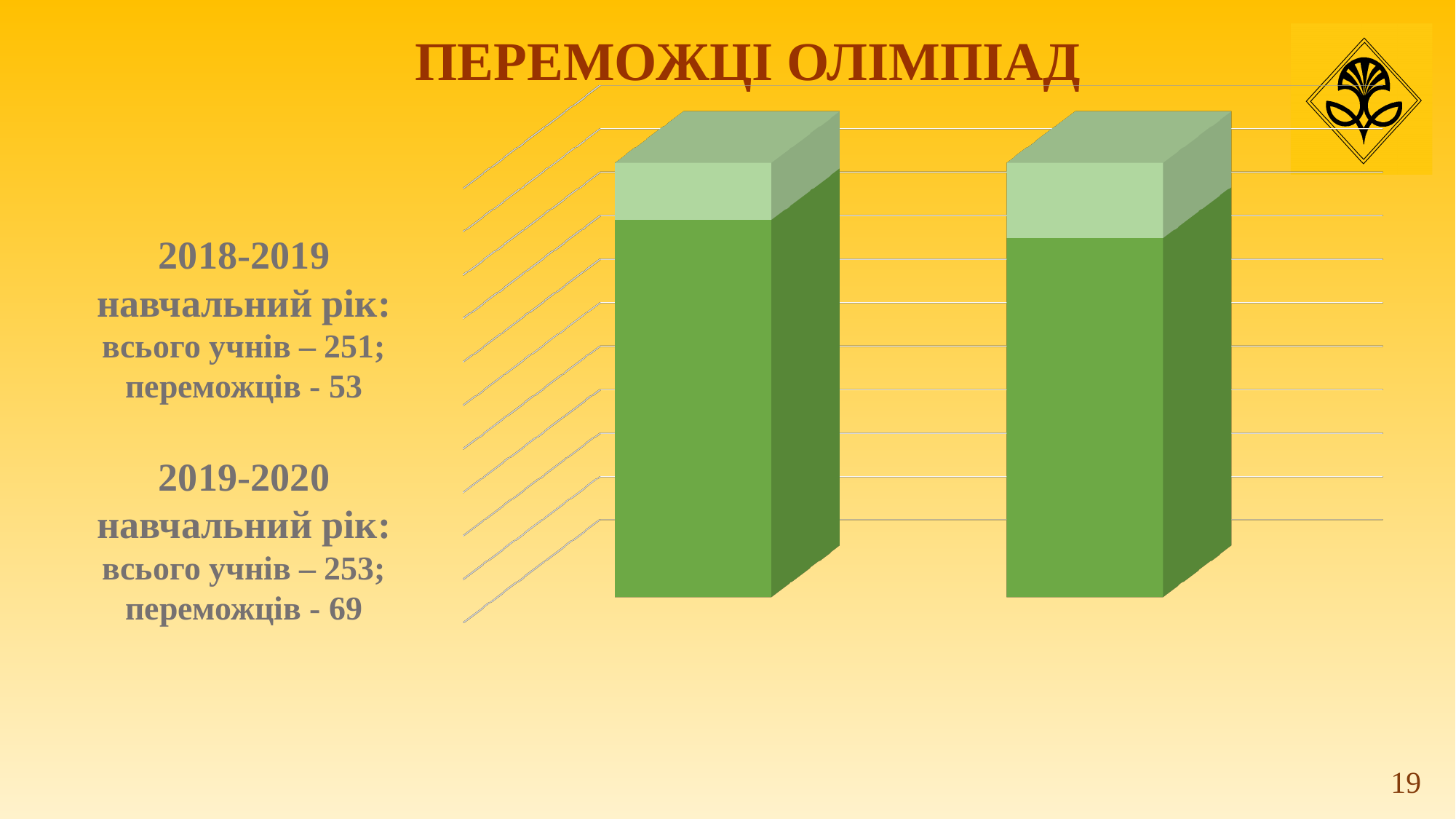
Which bar has the larger light-green top segment, the left bar or the right bar? the right bar Which bar has the larger dark-green segment, the left bar or the right bar? the left bar How many bars does the chart show? 2 What kind of chart is shown on the slide? bar chart What two colours are used for the segments of the stacked bars? dark green and light green What is the title of the slide containing the chart? ПЕРЕМОЖЦІ ОЛІМПІАД